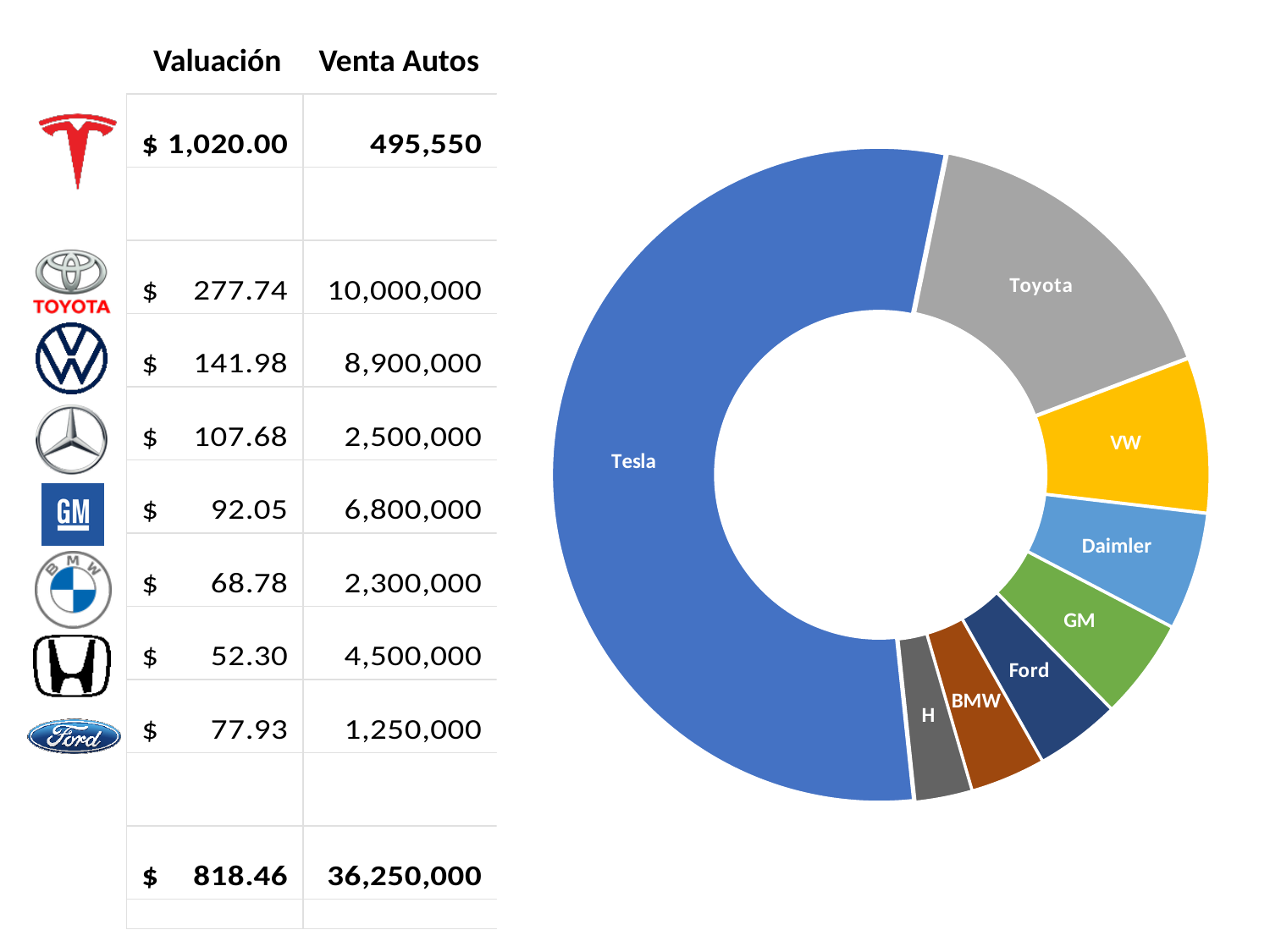
What colour is the Tesla slice in the doughnut chart? Blue Which slice is larger in the doughnut chart, Tesla or Toyota? Tesla Which slice of the doughnut chart is the smallest? H Which slice is larger in the doughnut chart, VW or BMW? VW Which slice is larger in the doughnut chart, Toyota or VW? Toyota Which slice of the doughnut chart is coloured yellow? VW Which slice of the doughnut chart is the largest? Tesla How many labelled slices does the doughnut chart have? 8 Does the Tesla slice take up more or less than half of the doughnut chart? more What kind of chart is shown on the slide? Doughnut chart